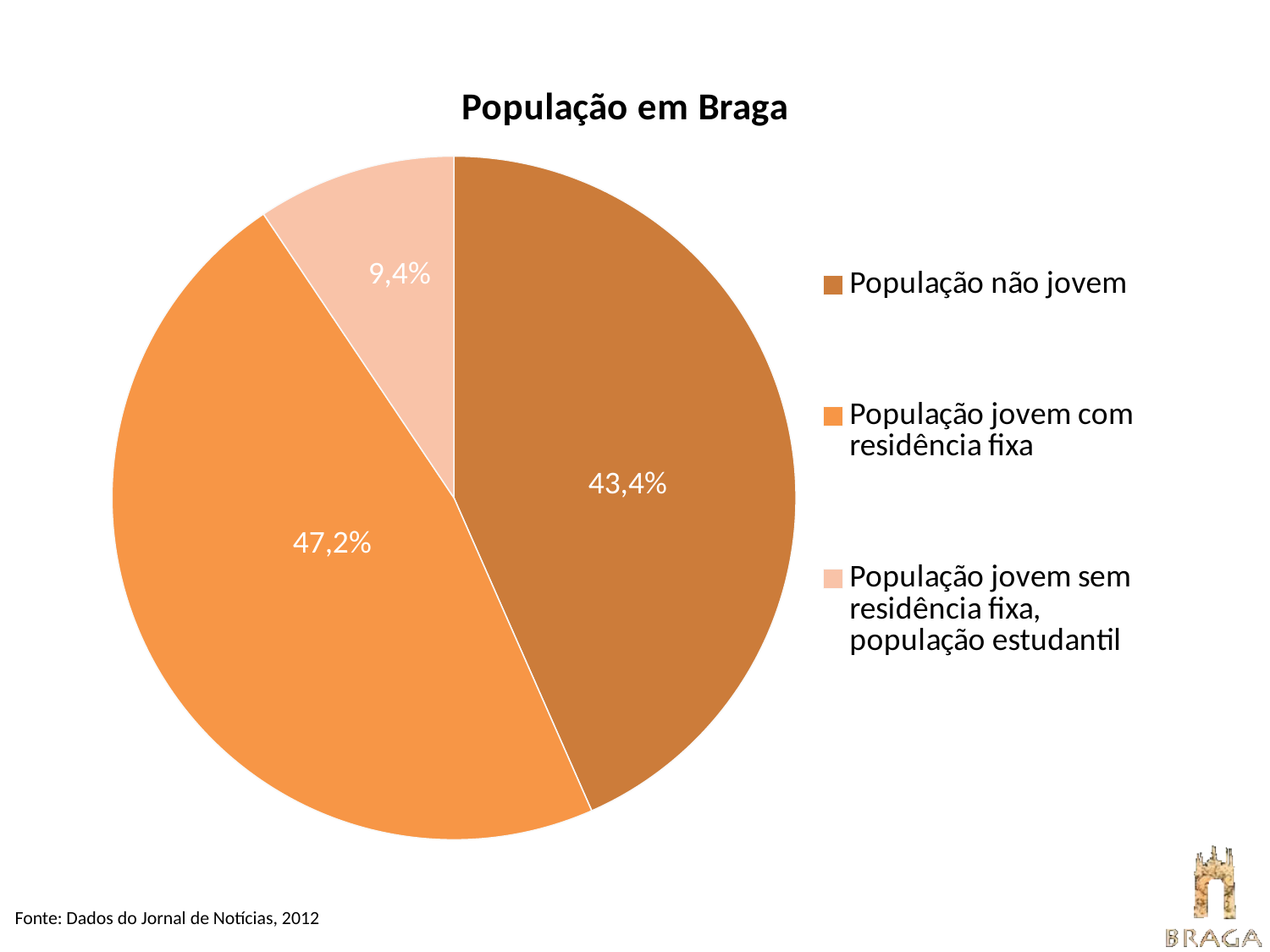
What share of the pie is 'População jovem com residência fixa'? 47,2% Which is larger: the slice for 'População não jovem' or the slice for 'População jovem sem residência fixa, população estudantil'? População não jovem What is the title of the chart? População em Braga Which category has the largest slice of the pie? População jovem com residência fixa What share of the pie is 'População não jovem'? 43,4% How many slices does the pie chart have? 3 What is the source cited below the chart? Dados do Jornal de Notícias, 2012 What kind of chart is shown on the slide? pie chart What is the difference in percentage points between 'População jovem com residência fixa' and 'População não jovem'? 3,8 What is the difference in percentage points between 'População não jovem' and 'População jovem sem residência fixa, população estudantil'? 34 What share of the pie is 'População jovem sem residência fixa, população estudantil'? 9,4% Which category has the smallest slice of the pie? População jovem sem residência fixa, população estudantil